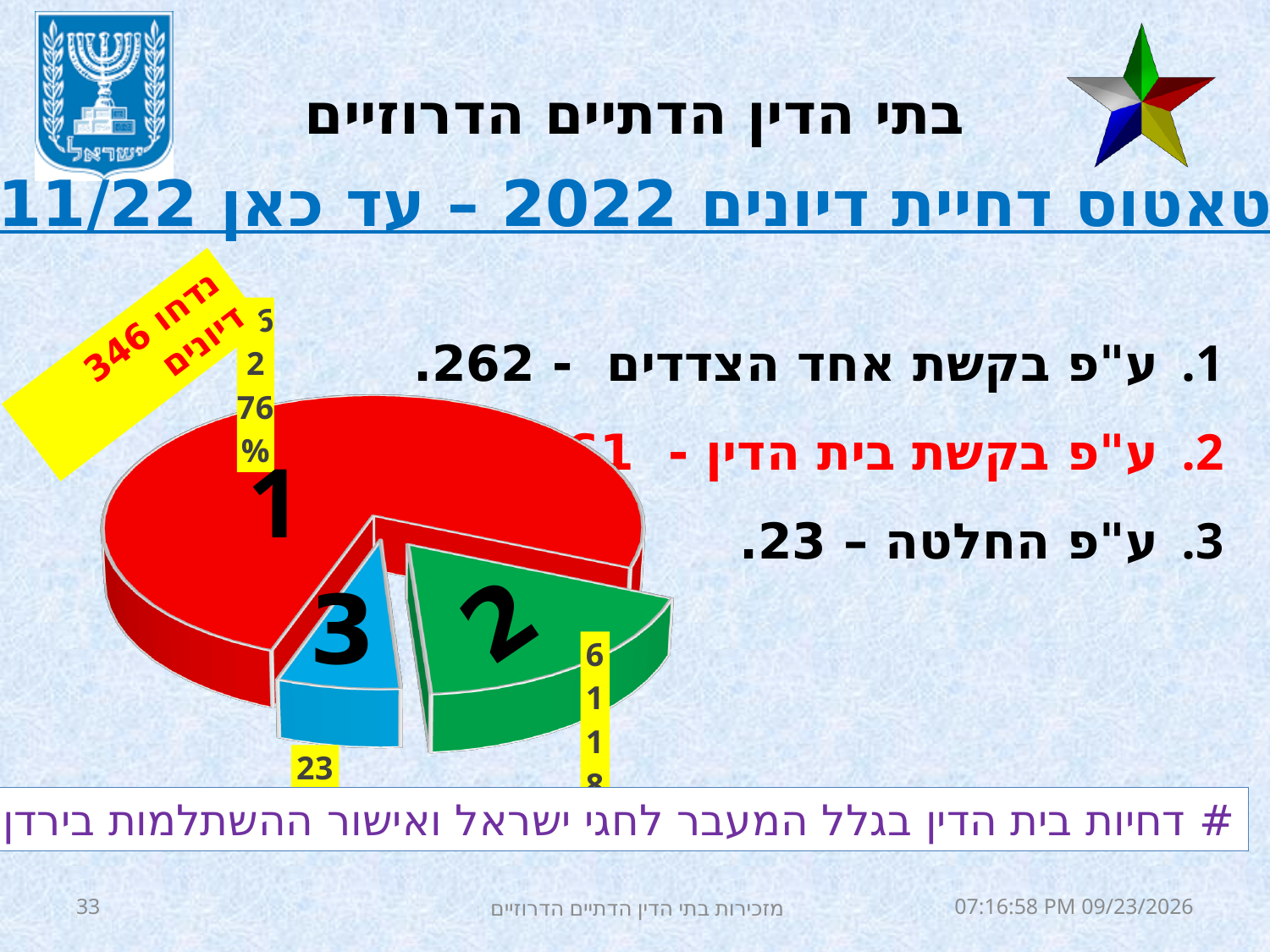
What colour is slice 1 of the pie chart? red According to the slide text, what is the value for category 1 (ע"פ בקשת אחד הצדדים)? 262 What kind of chart is shown on the slide? pie chart Which slice of the pie chart is the smallest? 3 What is the difference between the value for category 1 (262) and the value for slice 3 (23)? 239 How many slices does the pie chart have? 3 What colour is slice 3 of the pie chart? blue Which slice of the pie chart is the largest? 1 Which is larger, slice 2 or slice 3 of the pie chart? slice 2 What percentage share of the pie does slice 1 have? 76% What value is labelled on slice 3 of the pie chart? 23